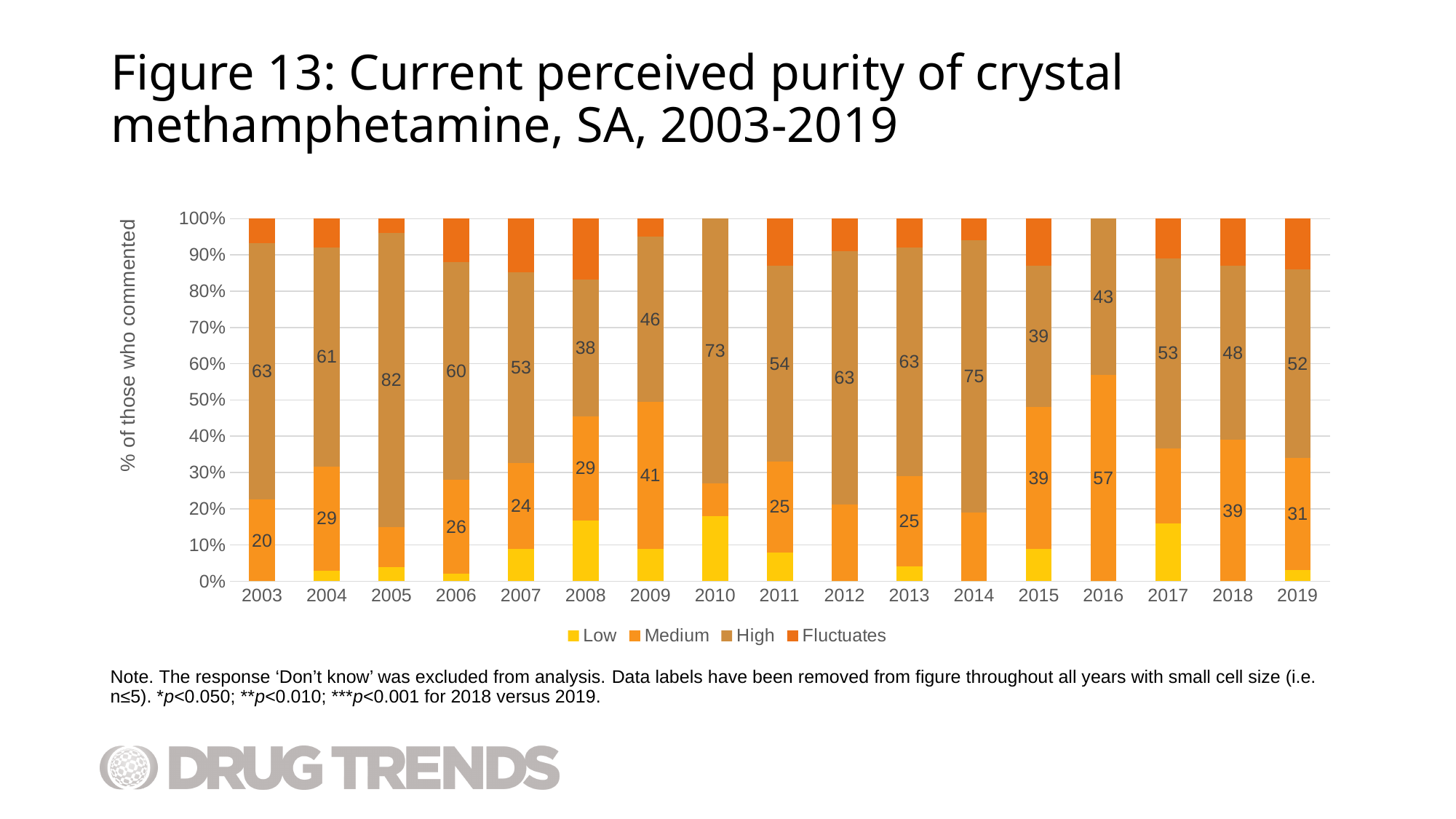
What is the data label for the High series in 2019? 52 How many years are shown on the x axis? 17 Which is larger, the Medium value in 2016 or the Medium value in 2009? Medium value in 2016 What is the data label for the Medium series in 2016? 57 What is the data label for the Medium series in 2003? 20 What is the data label for the High series in 2005? 82 What is the difference between the High value in 2005 and the High value in 2008? 44 How many series does the legend list? 4 In which year does the High series have its largest labelled value? 2005 In which year does the Medium series have its smallest labelled value? 2003 What kind of chart is shown on the slide? Stacked bar chart Is the Low segment for 2010 greater or less than 10%? greater